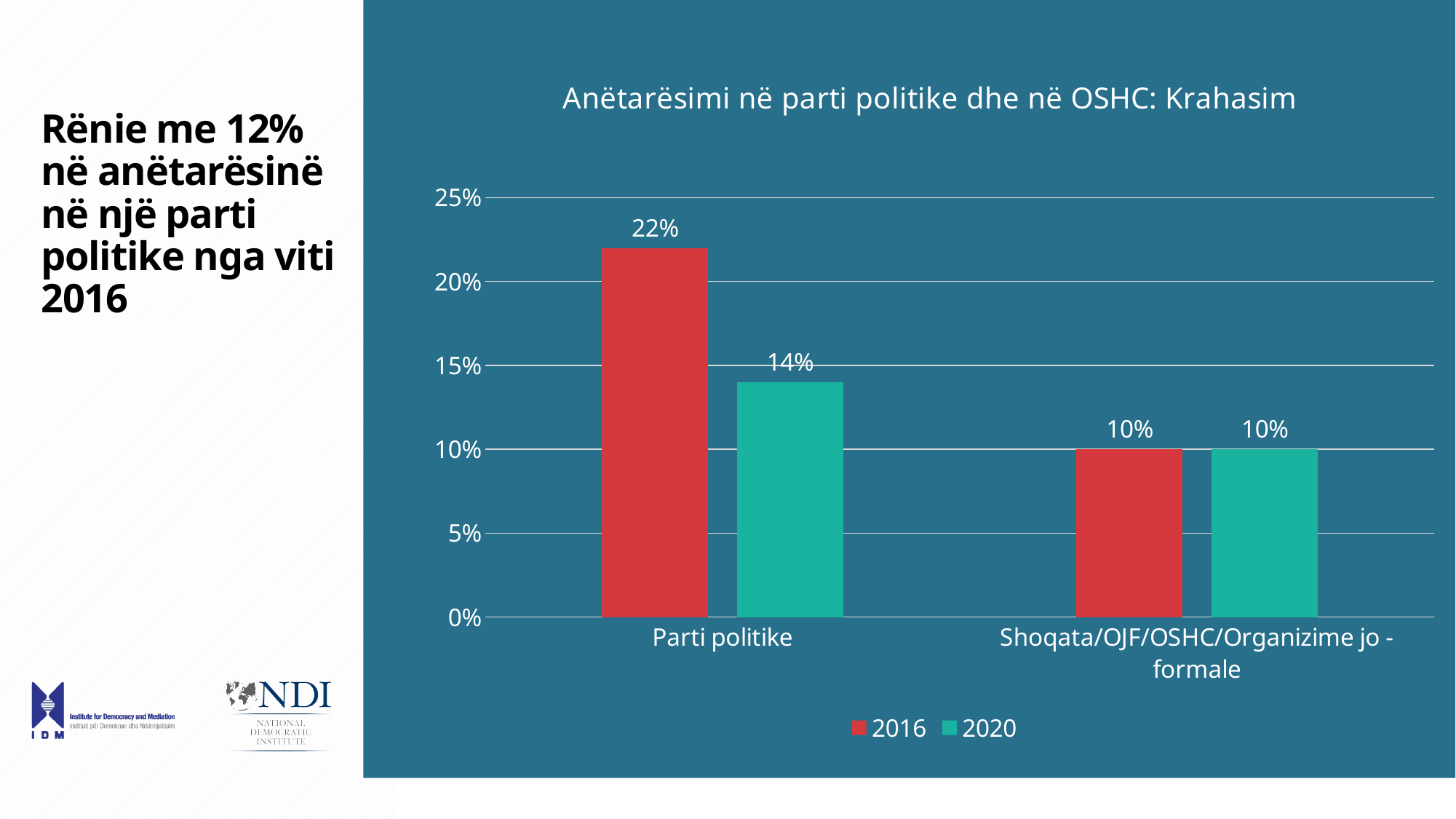
What kind of chart is shown on the slide? Bar chart Which is larger for Parti politike: the 2016 value or the 2020 value? 2016 What is the value for Shoqata/OJF/OSHC/Organizime jo-formale in 2016? 10% Which category has the highest value in the 2016 series? Parti politike What is the difference between the 2016 and 2020 values for Parti politike? 8% How many categories are shown on the x axis? 2 What is the value for Parti politike in 2020? 14% What is the value for Parti politike in 2016? 22% How many series does the legend list? 2 What is the value for Shoqata/OJF/OSHC/Organizime jo-formale in 2020? 10% What is the title of the chart? Anëtarësimi në parti politike dhe në OSHC: Krahasim Which category has the lowest value in the 2020 series? Shoqata/OJF/OSHC/Organizime jo-formale